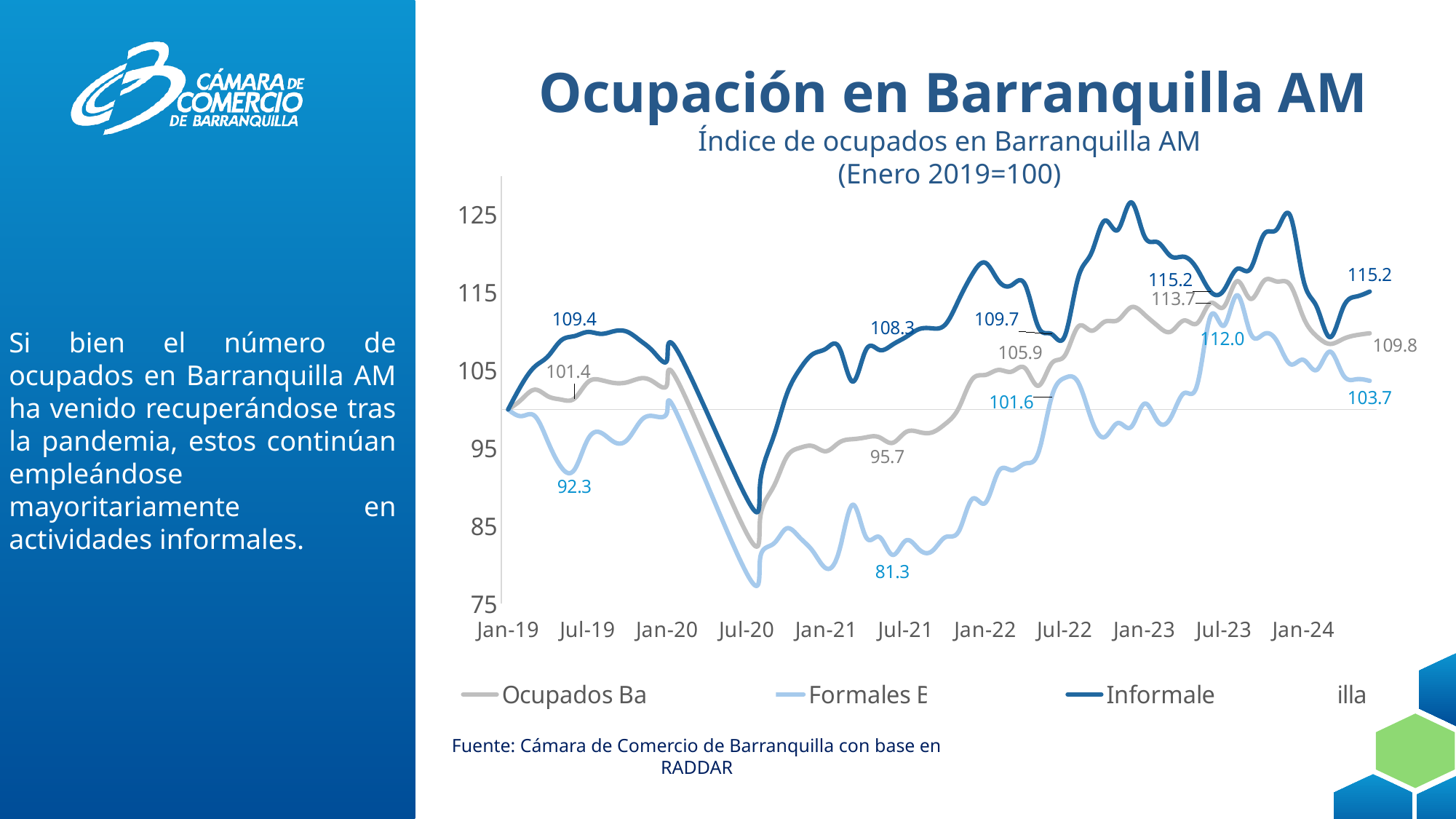
How many series does the chart legend list? 3 What kind of chart is shown on the slide? Line chart What is the lowest labelled value on the light blue (Formales) line? 81.3 According to the chart subtitle, which month is the base period of the index (=100)? Enero 2019 What is the last labelled value of the light blue (Formales) line, at the right end of the chart? 103.7 At the right end of the chart, which line is higher: the dark blue (Informales) or the light blue (Formales)? Informales (dark blue) What is the last labelled value of the dark blue (Informales) line, at the right end of the chart? 115.2 Does the light blue (Formales) line rise or fall between Jan-19 and Jul-20? Fall What is the last labelled value of the grey (Ocupados) line, at the right end of the chart? 109.8 What is the first labelled value on the grey (Ocupados) line, near Jul-19? 101.4 Around Jul-20, is the value of the light blue (Formales) line greater or less than 85? less What is the difference between the final labelled values of the dark blue (Informales) line and the light blue (Formales) line? 11.5